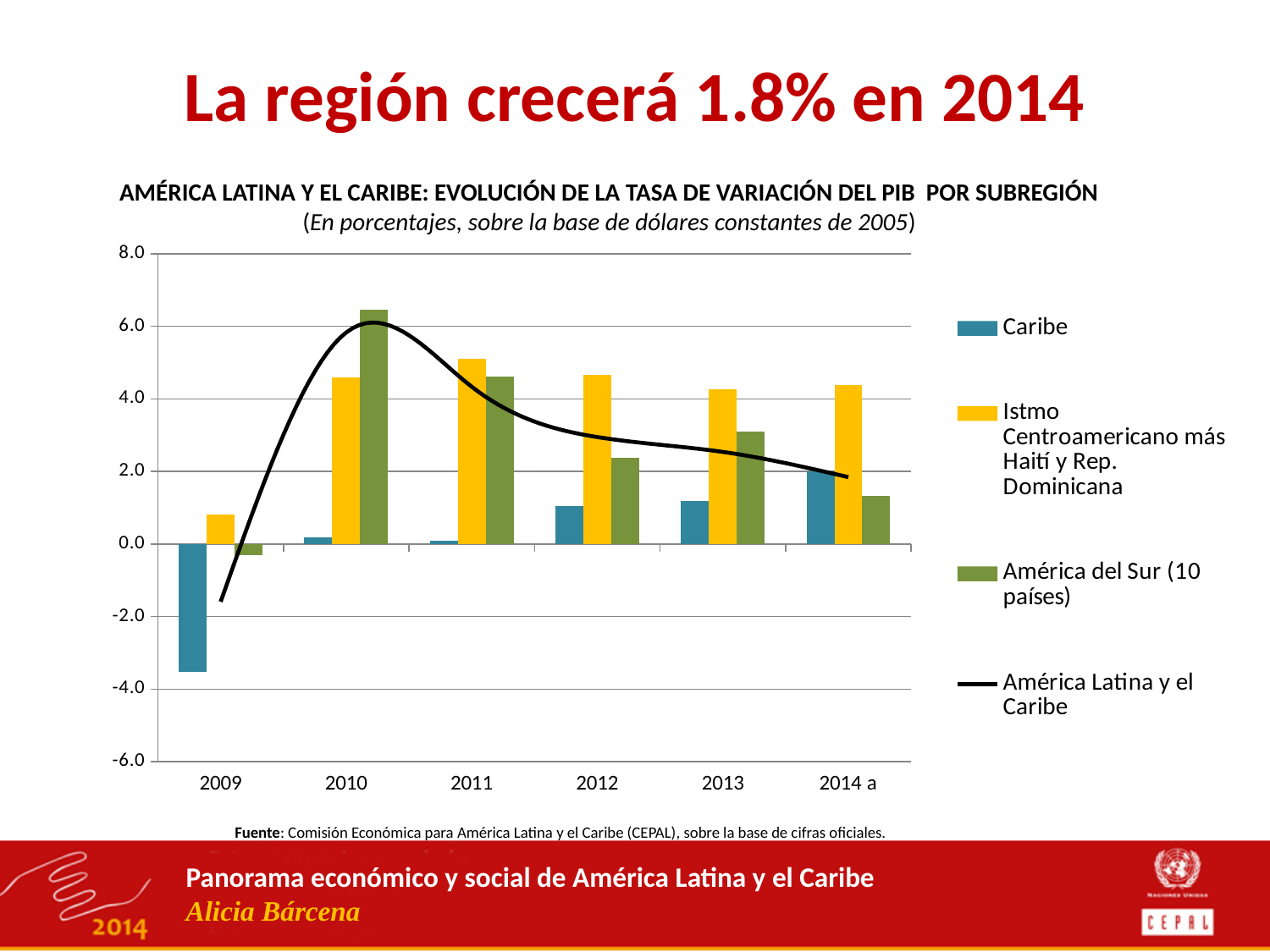
Is the Caribe value for 2009 greater or less than -2.0? less What is the title of the chart? AMÉRICA LATINA Y EL CARIBE: EVOLUCIÓN DE LA TASA DE VARIACIÓN DEL PIB POR SUBREGIÓN In 2013, which is larger: the Istmo Centroamericano más Haití y Rep. Dominicana value or the América del Sur (10 países) value? Istmo Centroamericano más Haití y Rep. Dominicana In which year is the América del Sur (10 países) value highest? 2010 Is the América del Sur (10 países) value for 2010 greater or less than 6.0? greater Does the América del Sur (10 países) value rise or fall from 2010 to 2014 a? fall How many series does the legend list? 4 What kind of chart is this? Bar chart with a line In which year is the Caribe value lowest? 2009 Which series is drawn as a black line? América Latina y el Caribe How many years are shown on the x axis? 6 Is the Istmo Centroamericano más Haití y Rep. Dominicana value for 2014 a greater or less than 4.0? greater